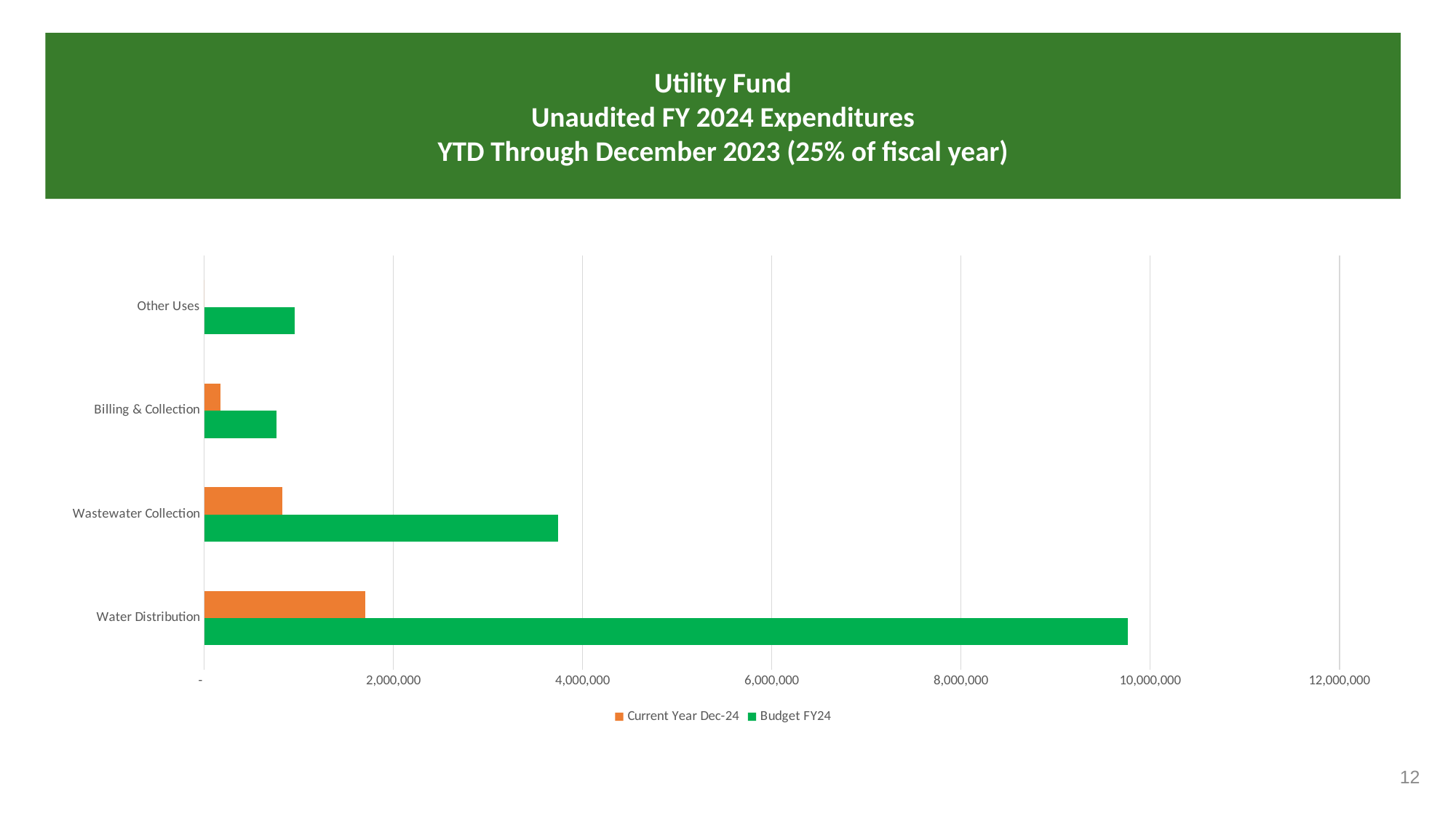
Is the Budget FY24 value for Water Distribution greater or less than 8,000,000? greater Is the Current Year Dec-24 value for Water Distribution greater or less than 2,000,000? less What kind of chart is shown on the slide? Bar chart How many series does the legend list? 2 How many categories are shown on the chart? 4 Is the Budget FY24 value for Billing & Collection greater or less than 2,000,000? less What is the title of the slide containing the chart? Utility Fund Unaudited FY 2024 Expenditures YTD Through December 2023 (25% of fiscal year) Which category has the highest Current Year Dec-24 value? Water Distribution Which category has the highest Budget FY24 value? Water Distribution Which series is shown in orange in the legend? Current Year Dec-24 Which is larger: the Budget FY24 value for Wastewater Collection or the Budget FY24 value for Billing & Collection? Wastewater Collection